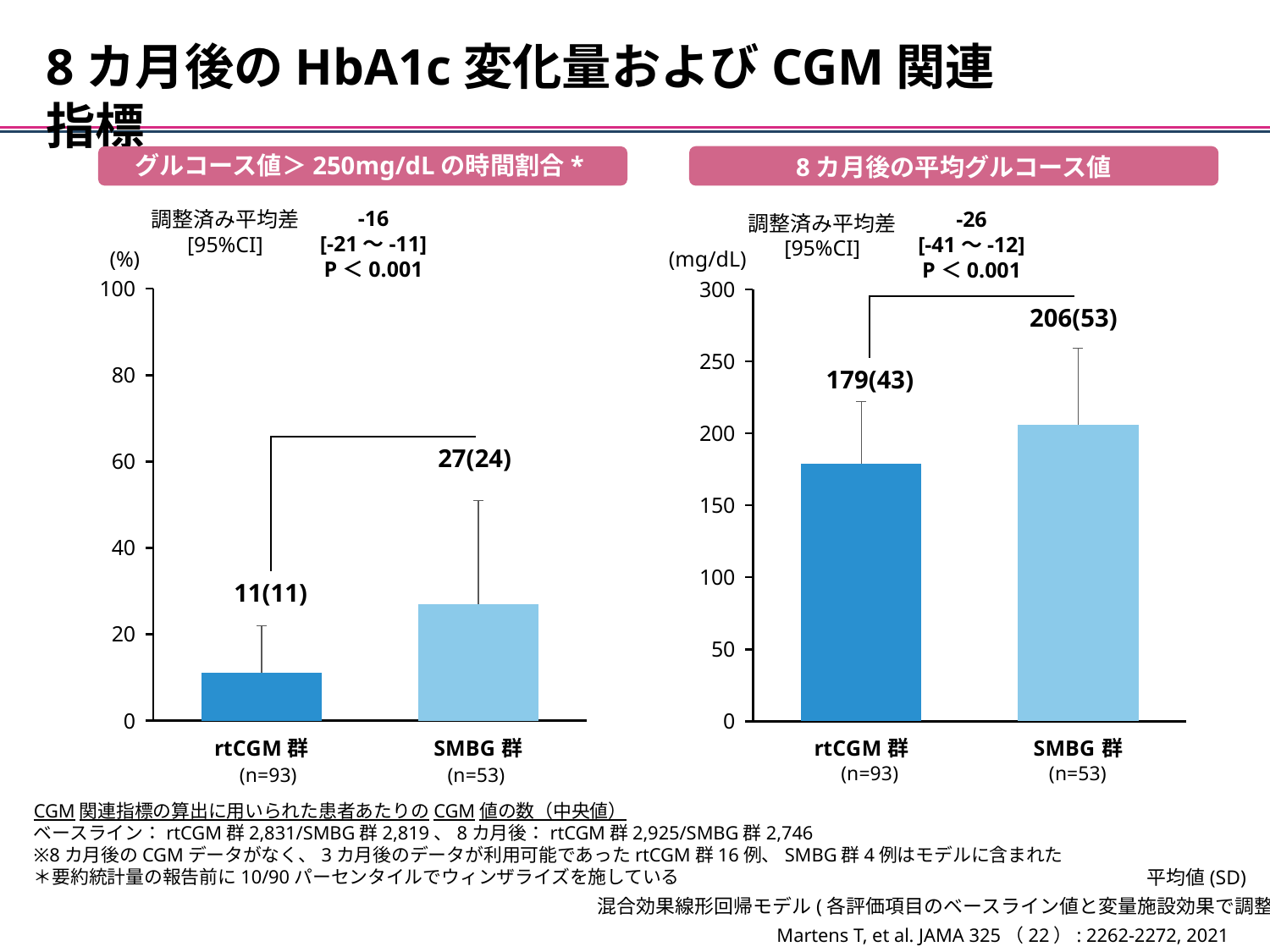
In the right chart (8 カ月後の平均グルコース値), is the bar for SMBG 群 greater or less than 200? greater In the right chart (8 カ月後の平均グルコース値), what value is labeled on the bar for SMBG 群? 206(53) In the left chart (グルコース値＞250mg/dL の時間割合), what value is labeled on the bar for SMBG 群? 27(24) In the left chart (グルコース値＞250mg/dL の時間割合), what is the difference between the mean values of SMBG 群 (27) and rtCGM 群 (11)? 16 In the left chart (グルコース値＞250mg/dL の時間割合), what value is labeled on the bar for rtCGM 群? 11(11) What type of chart is the right chart (8 カ月後の平均グルコース値)? bar chart In the left chart (グルコース値＞250mg/dL の時間割合), which group has the higher bar? SMBG 群 In the right chart (8 カ月後の平均グルコース値), what is the difference between the mean values of SMBG 群 (206) and rtCGM 群 (179)? 27 How many groups (bars) are shown in the left chart (グルコース値＞250mg/dL の時間割合)? 2 In the right chart (8 カ月後の平均グルコース値), what adjusted mean difference [95%CI] is printed above the bars? -26 [-41 ～ -12] In the right chart (8 カ月後の平均グルコース値), which group has the lower bar? rtCGM 群 In the right chart (8 カ月後の平均グルコース値), what value is labeled on the bar for rtCGM 群? 179(43)